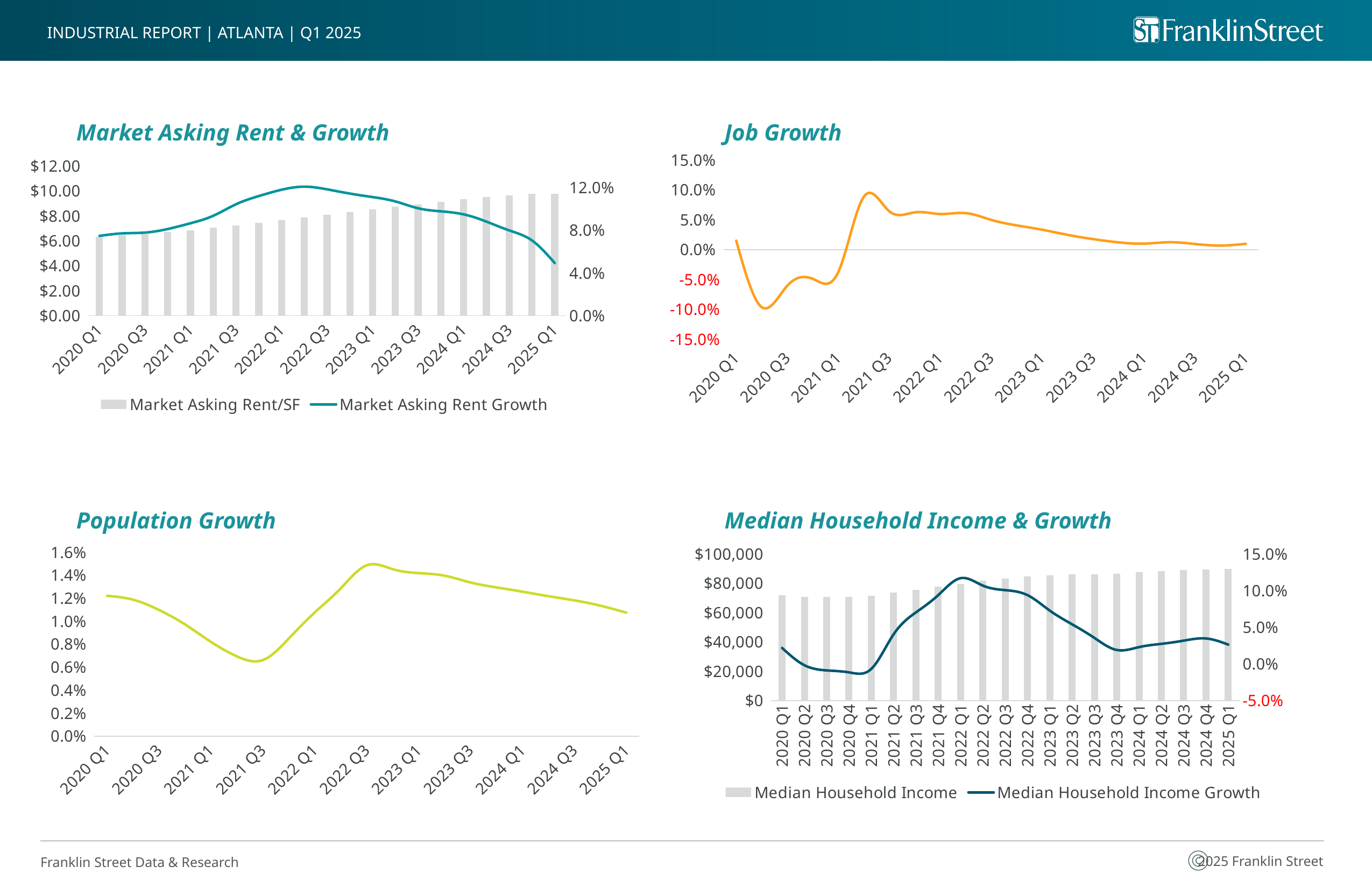
What kind of chart is the Job Growth chart? line chart How many bars are plotted in the Median Household Income & Growth chart? 21 In the Job Growth chart, is the value for 2025 Q1 greater or less than 5.0%? less In the Population Growth chart, which quarter has the lowest value? 2021 Q3 In the Market Asking Rent & Growth chart, is the Market Asking Rent Growth for 2025 Q1 greater or less than 8.0%? less In the Market Asking Rent & Growth chart, is the Market Asking Rent/SF for 2025 Q1 greater or less than $8.00? greater In the Population Growth chart, which quarter has the highest value? 2022 Q3 In the Market Asking Rent & Growth chart, do the Market Asking Rent/SF bars rise or fall from 2020 Q1 to 2025 Q1? rise How many series does the legend of the Market Asking Rent & Growth chart list? 2